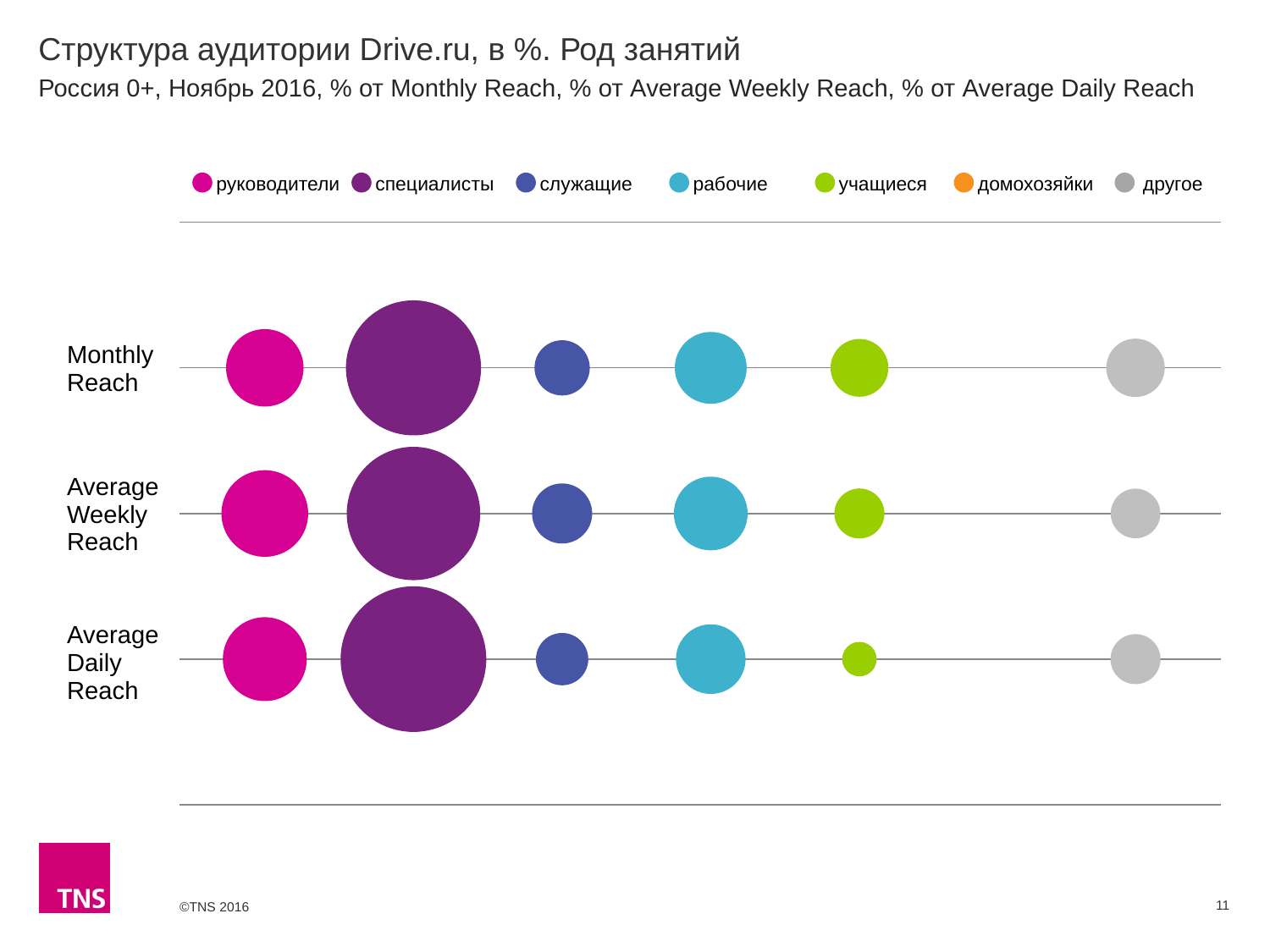
How many series does the legend list? 7 In the Average Daily Reach row, which is larger: руководители or другое? руководители What kind of chart is shown on the slide? bubble chart Which occupation group has the largest bubble in the Monthly Reach row? специалисты Which occupation group has the largest bubble in the Average Daily Reach row? специалисты In the Monthly Reach row, which is larger: рабочие or служащие? рабочие How many reach categories (rows) are plotted on the chart? 3 Which occupation group is shown in grey in the legend? другое For учащиеся, which row has the larger bubble: Monthly Reach or Average Daily Reach? Monthly Reach What is the title of the chart on the slide? Структура аудитории Drive.ru, в %. Род занятий Which visible occupation group has the smallest bubble in the Average Daily Reach row? учащиеся